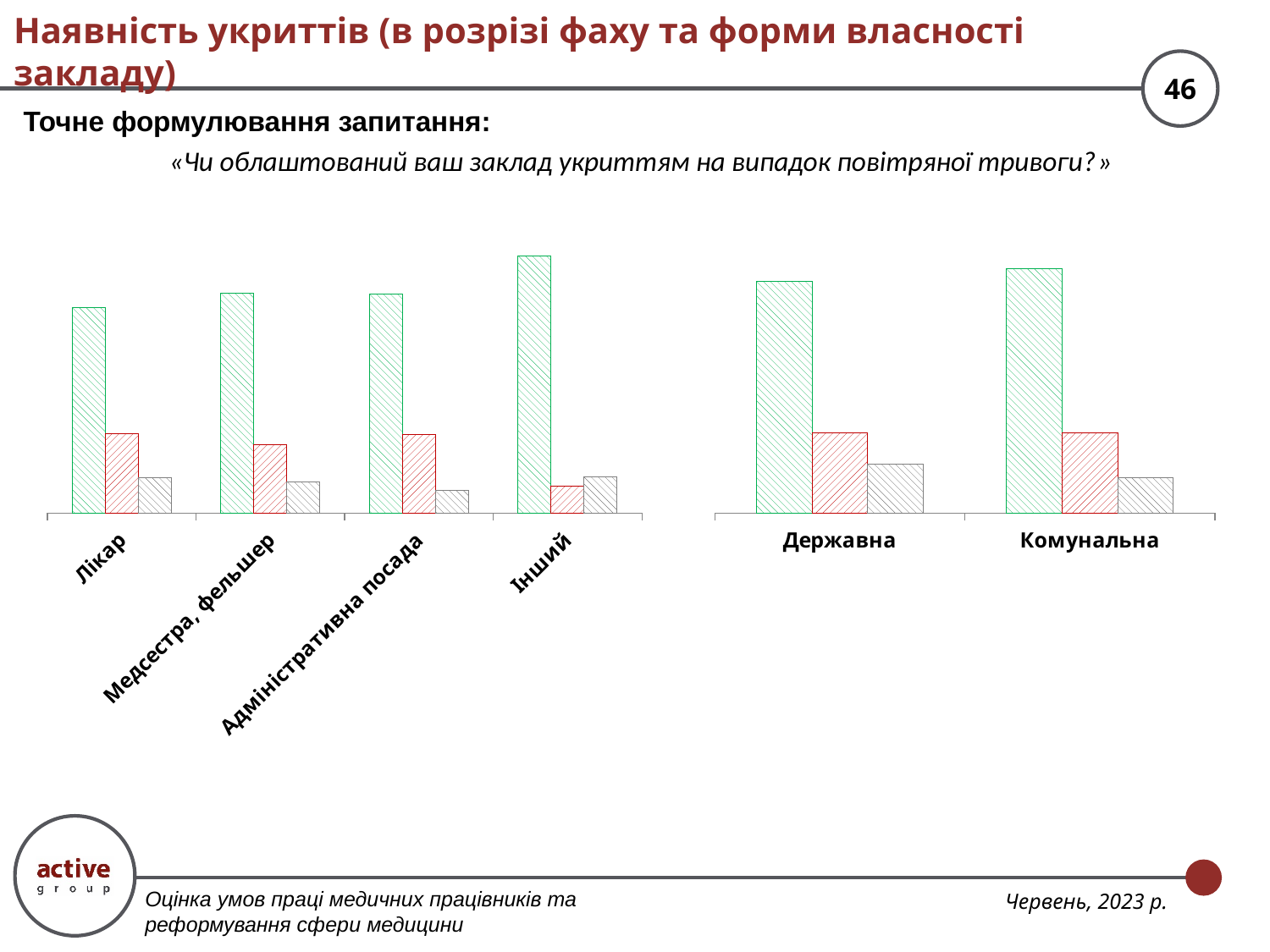
In the left chart, how many bars are shown for each category? 3 In the right chart, which category has the taller grey bar, Державна or Комунальна? Державна In the left chart, is the green bar for Лікар taller or shorter than the green bar for Інший? shorter What kind of chart is the right chart on the slide? bar chart How many categories are shown on the x axis of the right chart? 2 How many categories are shown on the x axis of the left chart? 4 What kind of chart is the left chart on the slide? bar chart In the left chart, which category has the shortest green bar? Лікар In the left chart, which category has the tallest green bar? Інший In the right chart, which category has the taller green bar, Державна or Комунальна? Комунальна In the left chart, which category has the shortest red bar? Інший What are the two category labels on the x axis of the right chart? Державна, Комунальна